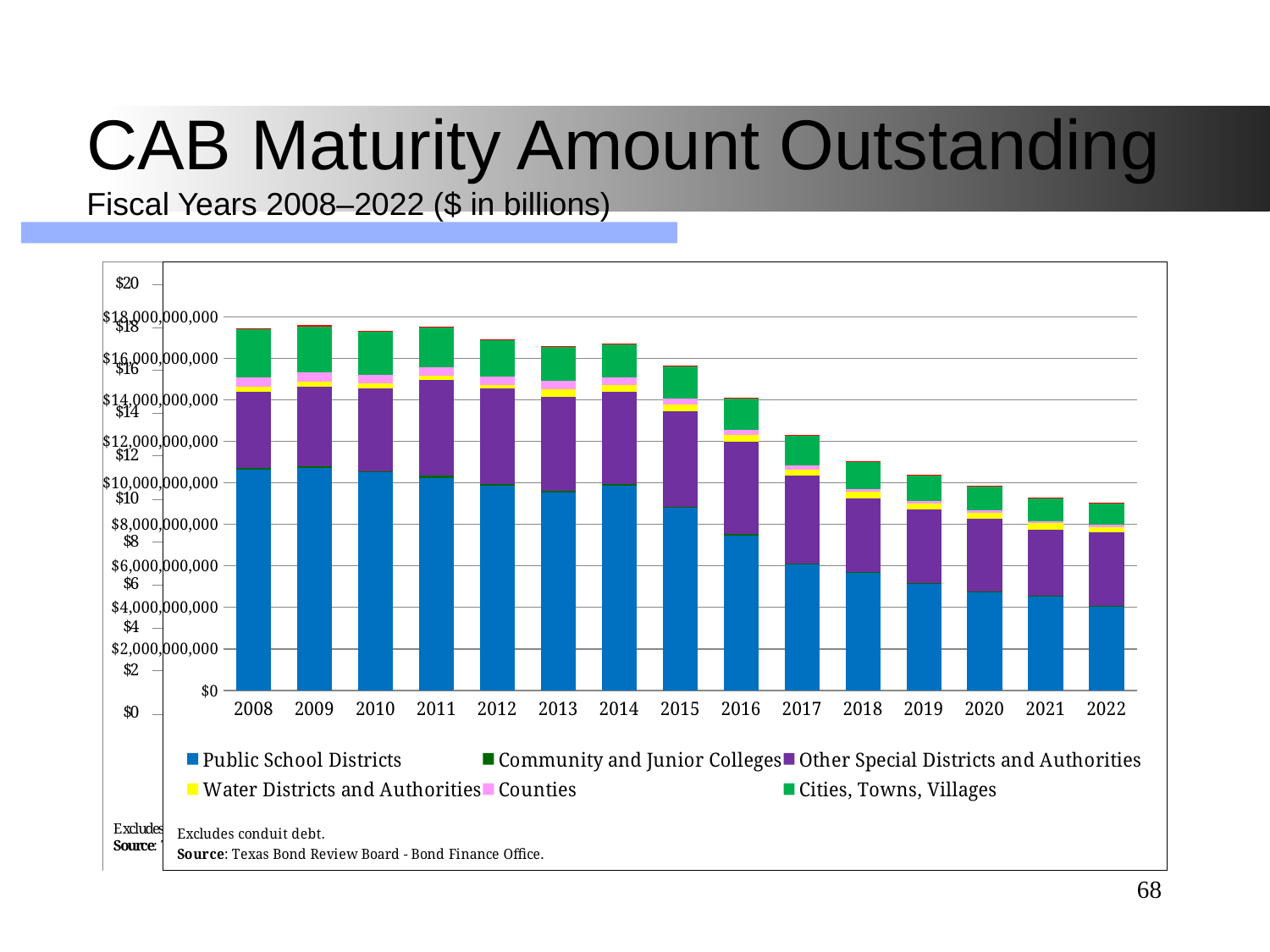
Is the Public School Districts value for 2008 greater or less than $10,000,000,000? greater In which fiscal year is the Public School Districts segment smallest? 2022 Do the total bar heights generally rise or fall from 2008 to 2022? fall How many series does the legend list? 6 What kind of chart is shown on the slide? stacked bar chart Is the total value for 2018 greater or less than $12,000,000,000? less Which has the larger total bar, 2015 or 2020? 2015 How many fiscal years are plotted along the x axis? 15 Is the total value for 2008 greater or less than $16,000,000,000? greater Which fiscal year has the lowest total CAB maturity amount outstanding? 2022 Which series is shown in blue in the legend? Public School Districts